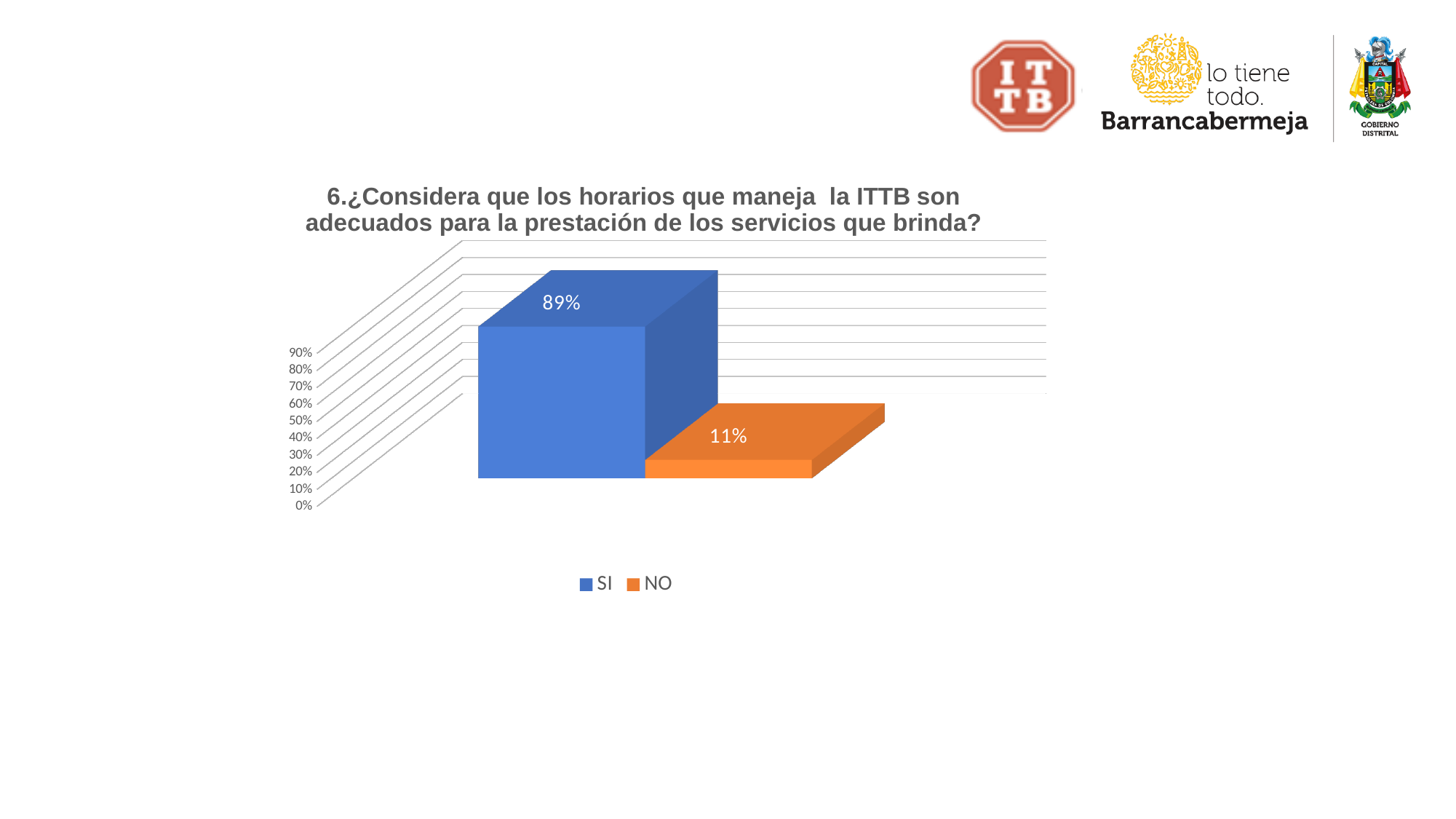
What is the total of the SI and NO values? 100% What is the value for SI? 89% Which is larger, the value for SI or the value for NO? SI What is the value for NO? 11% Is the value for SI greater or less than 50%? greater How many series does the legend list? 2 Which series has the lowest value? NO Which series has the highest value? SI What colour is the bar for NO? orange Is the value for NO greater or less than 20%? less What is the difference between the values for SI and NO? 78% What kind of chart is shown on the slide? bar chart